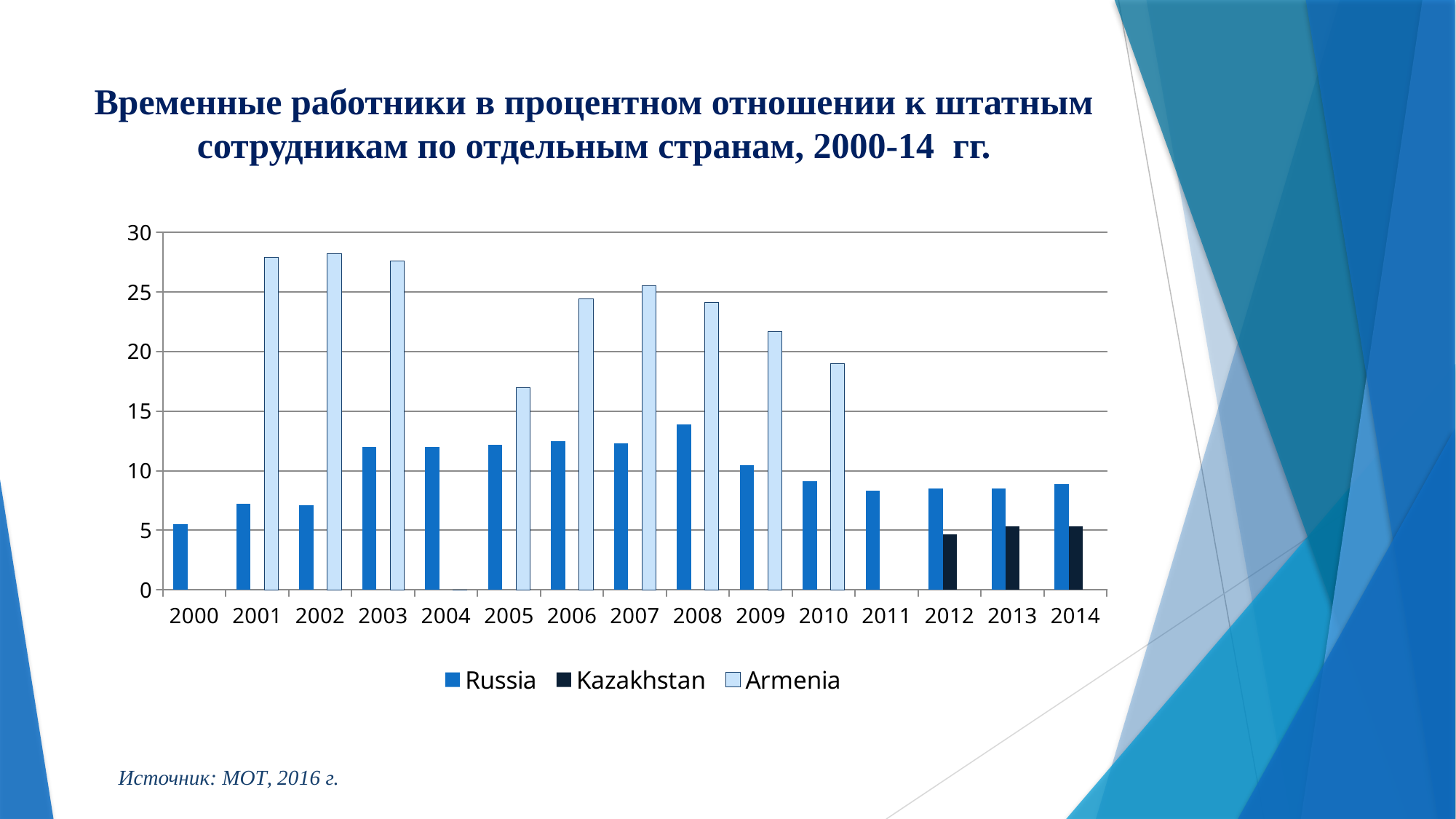
In which year is the value for Russia highest? 2008 Do the values for Armenia rise or fall from 2007 to 2010? fall Is the value for Russia in 2008 greater or less than 10? greater Which is larger for Russia, the value in 2008 or the value in 2009? 2008 What kind of chart is shown on the slide? bar chart In which year is the value for Russia lowest? 2000 Which is larger in 2001, the value for Russia or the value for Armenia? Armenia Is the value for Armenia in 2001 greater or less than 25? greater How many years are shown on the x axis? 15 Which series is shown in the darkest colour in the legend? Kazakhstan Is the value for Armenia in 2005 greater or less than 20? less How many series does the legend list? 3